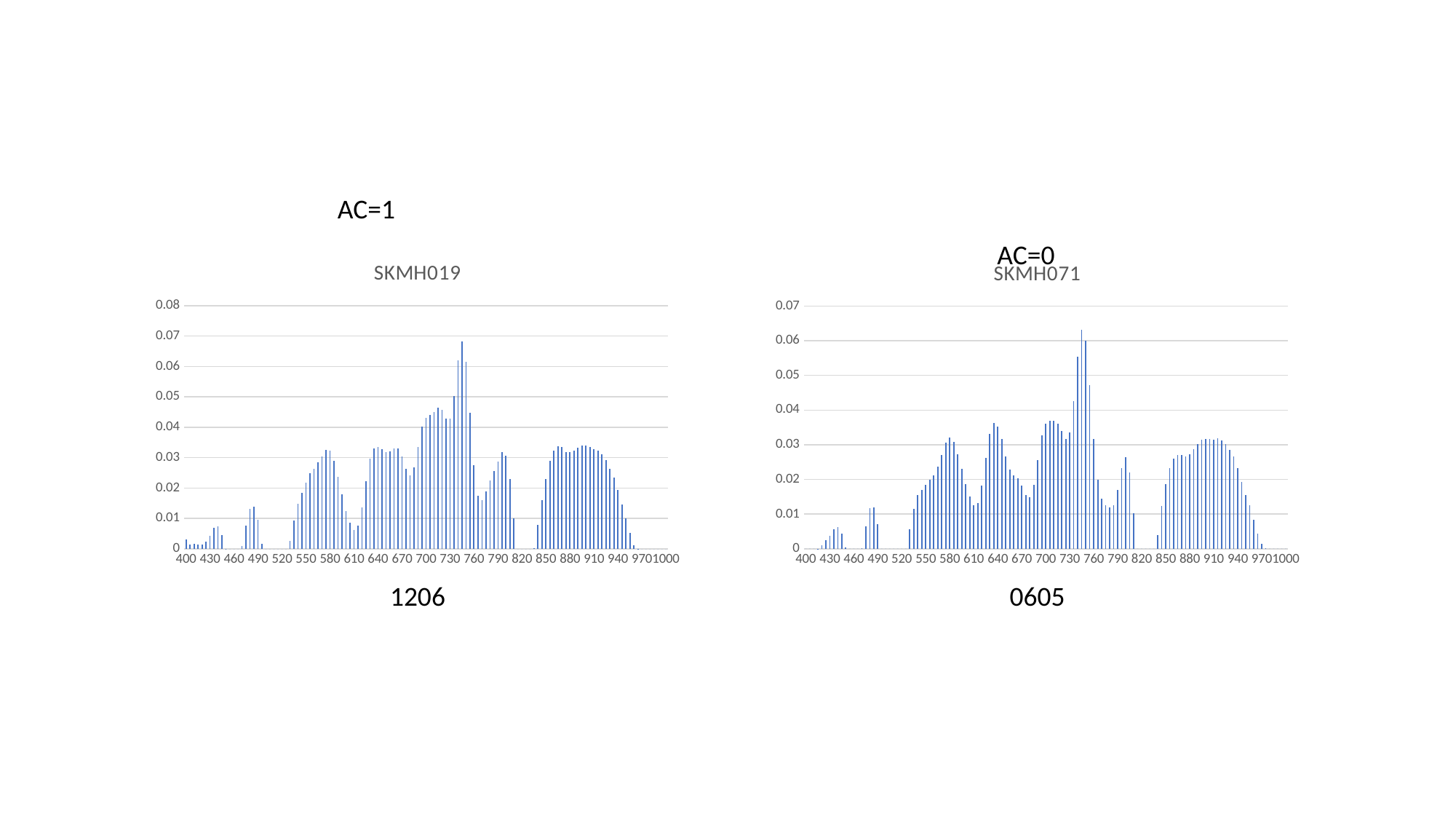
In the SKMH019 chart, is the value at 700 greater or less than 0.04? greater In the SKMH019 chart, is the tallest bar (near 745 on the x axis) greater or less than 0.06? greater What is the title of the chart on the left of the slide? SKMH019 In the SKMH019 chart, is the value at 880 greater or less than 0.03? greater What kind of chart is the SKMH071 chart? bar chart What kind of chart is the SKMH019 chart? bar chart What is the title of the chart on the right of the slide? SKMH071